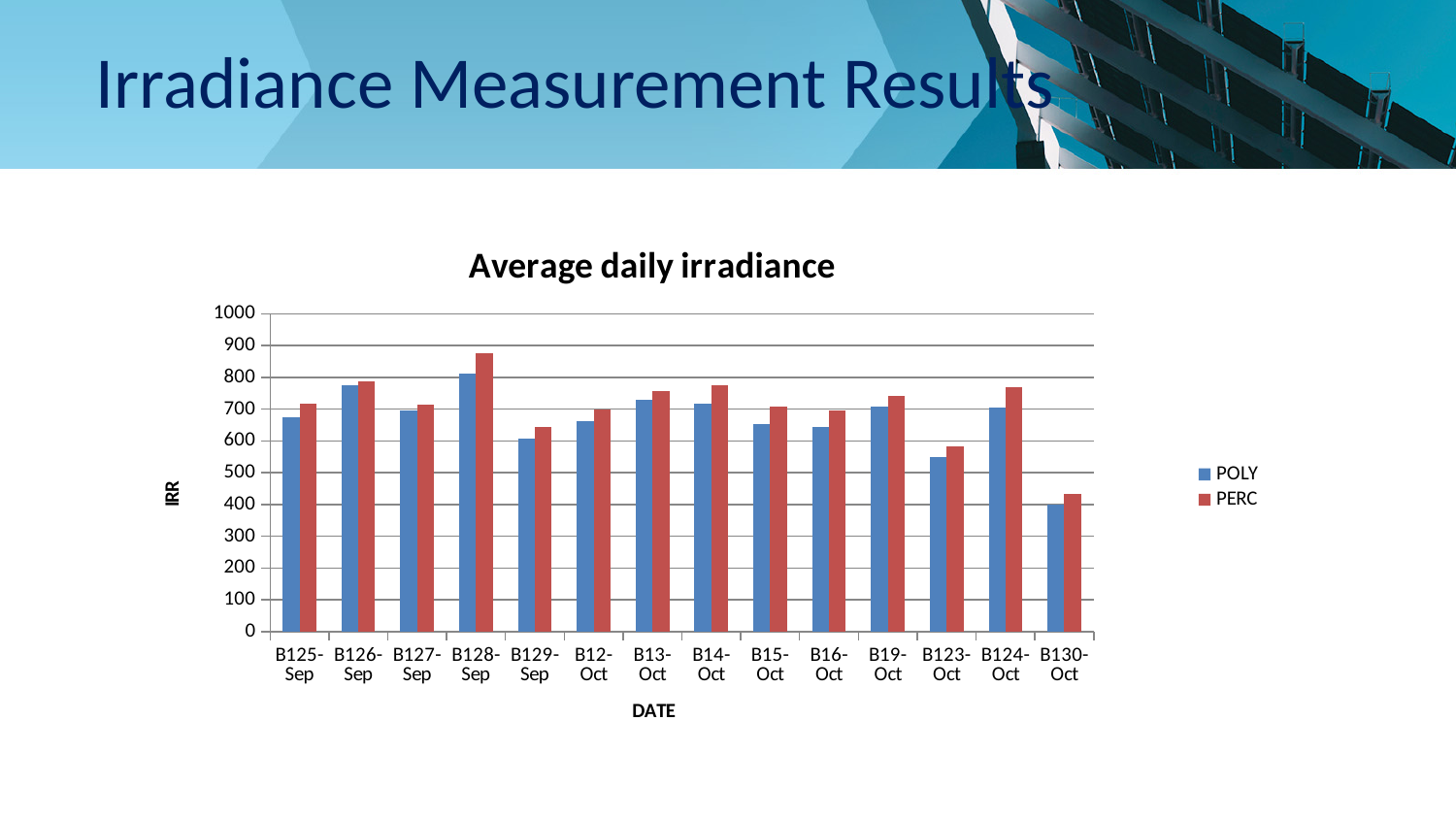
Is the PERC value for B123-Oct greater or less than 600? less Which date has the highest PERC value? B128-Sep What is the title of the chart? Average daily irradiance Is the PERC value for B128-Sep greater or less than 800? greater How many date categories are shown on the x axis? 14 Is the POLY value for B126-Sep greater or less than 700? greater How many series does the legend list? 2 What kind of chart is shown on the slide? bar chart Which date has the lowest POLY value? B130-Oct Which is larger: the POLY value for B126-Sep or the POLY value for B129-Sep? B126-Sep For B128-Sep, which series has the larger value, POLY or PERC? PERC